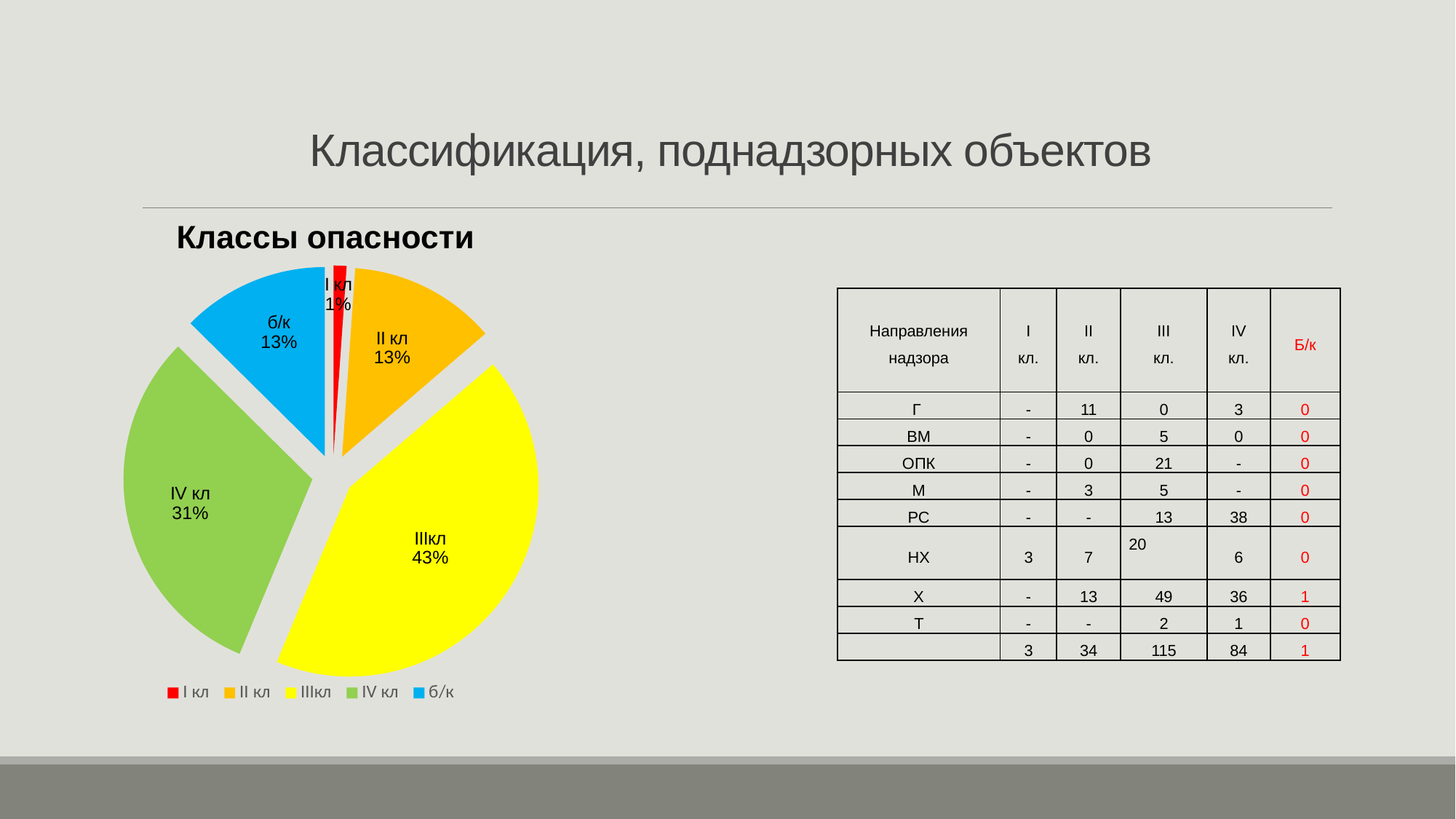
Which slice is larger, II кл or IV кл? IV кл What percentage is shown for the I кл slice? 1% What colour is the IIIкл slice in the pie chart? Yellow What percentage is shown for the б/к slice? 13% What share of the pie does the IIIкл slice represent? 43% Which slice of the pie chart is the largest? IIIкл What is the title of the pie chart? Классы опасности What is the difference in percentage points between the IIIкл slice and the IV кл slice? 12 How many slices does the pie chart have? 5 What share of the pie does the IV кл slice represent? 31% Which slice of the pie chart is the smallest? I кл What type of chart is shown under the title "Классы опасности"? Pie chart